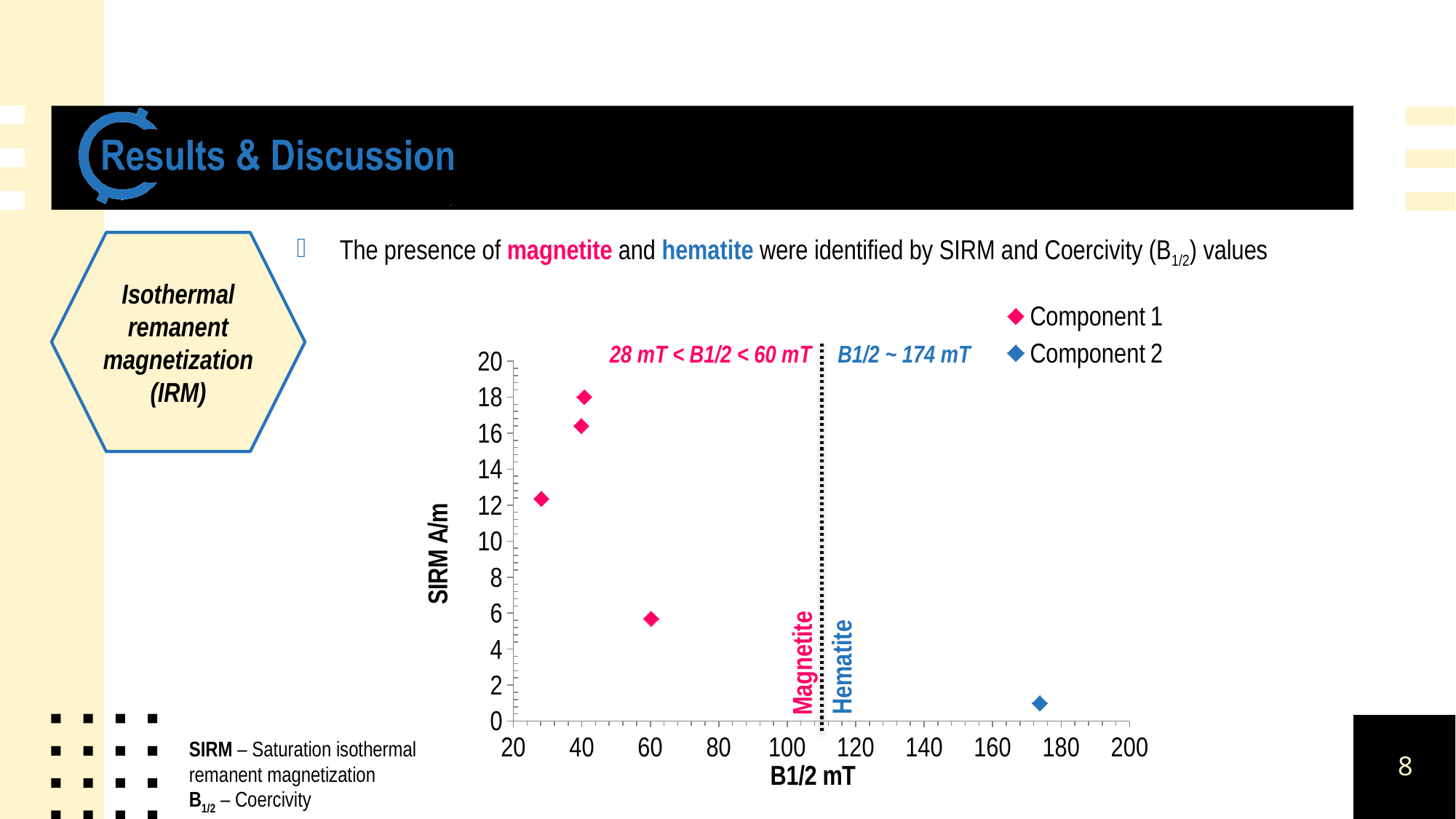
Which series has higher SIRM values, Component 1 or Component 2? Component 1 How many series does the chart legend list? 2 Is the SIRM value of the Component 2 point greater or less than 2 A/m? less What kind of chart is shown on the slide? Scatter chart How many data points are plotted for Component 1? 4 What is the title of the x axis of the chart? B1/2 mT How many data points are plotted for Component 2? 1 Is the B1/2 value of the Component 2 point greater or less than 160 mT? greater Is the highest SIRM value among the Component 1 points greater or less than 16 A/m? greater What B1/2 range is annotated on the chart for the magnetite (Component 1) points? 28 mT < B1/2 < 60 mT Which series has the point with the largest B1/2 value, Component 1 or Component 2? Component 2